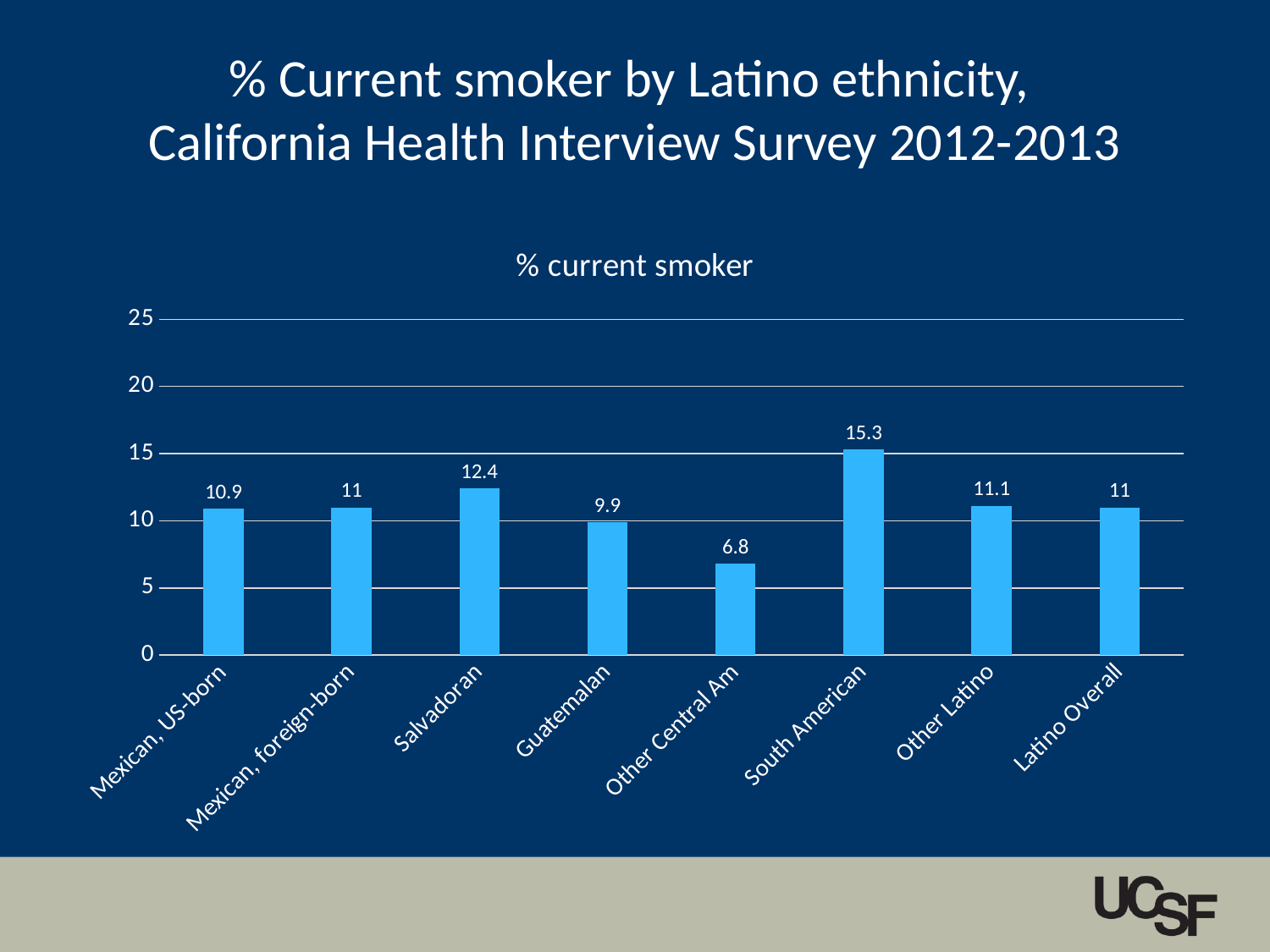
What is the % current smoker value for Salvadoran? 12.4 What is the % current smoker value for Other Central Am? 6.8 Is the value for South American greater or less than 15? greater Which Latino ethnicity has the lowest % current smoker? Other Central Am What is the difference in % current smoker between Salvadoran and Guatemalan? 2.5 What is the % current smoker value for Latino Overall? 11 What is the % current smoker value for South American? 15.3 What kind of chart is shown on the slide? Bar chart How many ethnicity categories are shown on the chart? 8 Which Latino ethnicity has the highest % current smoker? South American What is the difference in % current smoker between South American and Other Central Am? 8.5 Which has a higher % current smoker, Salvadoran or Guatemalan? Salvadoran